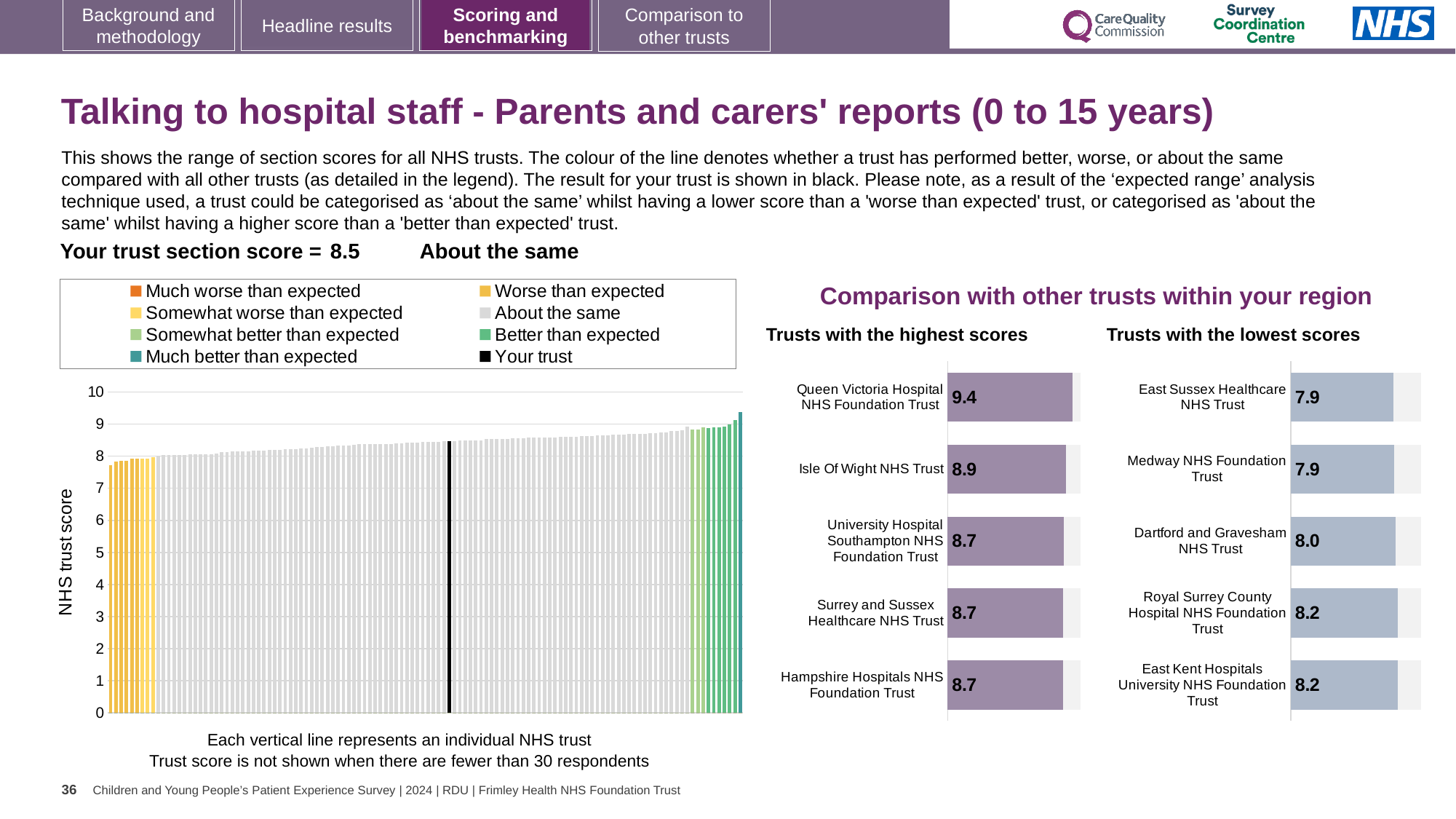
How many trusts are shown on the 'Trusts with the highest scores' chart? 5 On the 'NHS trust score' chart, is the value of the black 'Your trust' bar greater or less than 8? greater On the 'Trusts with the lowest scores' chart, what is the difference between the scores of East Kent Hospitals University NHS Foundation Trust and East Sussex Healthcare NHS Trust? 0.3 On the 'Trusts with the highest scores' chart, which trust has the highest score? Queen Victoria Hospital NHS Foundation Trust On the 'Trusts with the lowest scores' chart, what is the score for Dartford and Gravesham NHS Trust? 8.0 On the 'NHS trust score' chart, is the value of the tallest bar greater or less than 10? less On the 'NHS trust score' chart, what is the section score for your trust? 8.5 On the 'Trusts with the highest scores' chart, what is the difference between the scores of Queen Victoria Hospital NHS Foundation Trust and Isle Of Wight NHS Trust? 0.5 What kind of chart is the 'NHS trust score' chart on the left of the slide? bar chart On the 'Trusts with the lowest scores' chart, which is larger: the score for Dartford and Gravesham NHS Trust or the score for Royal Surrey County Hospital NHS Foundation Trust? Royal Surrey County Hospital NHS Foundation Trust On the 'Trusts with the highest scores' chart, what is the score for Queen Victoria Hospital NHS Foundation Trust? 9.4 How many entries does the legend above the 'NHS trust score' chart list? 8